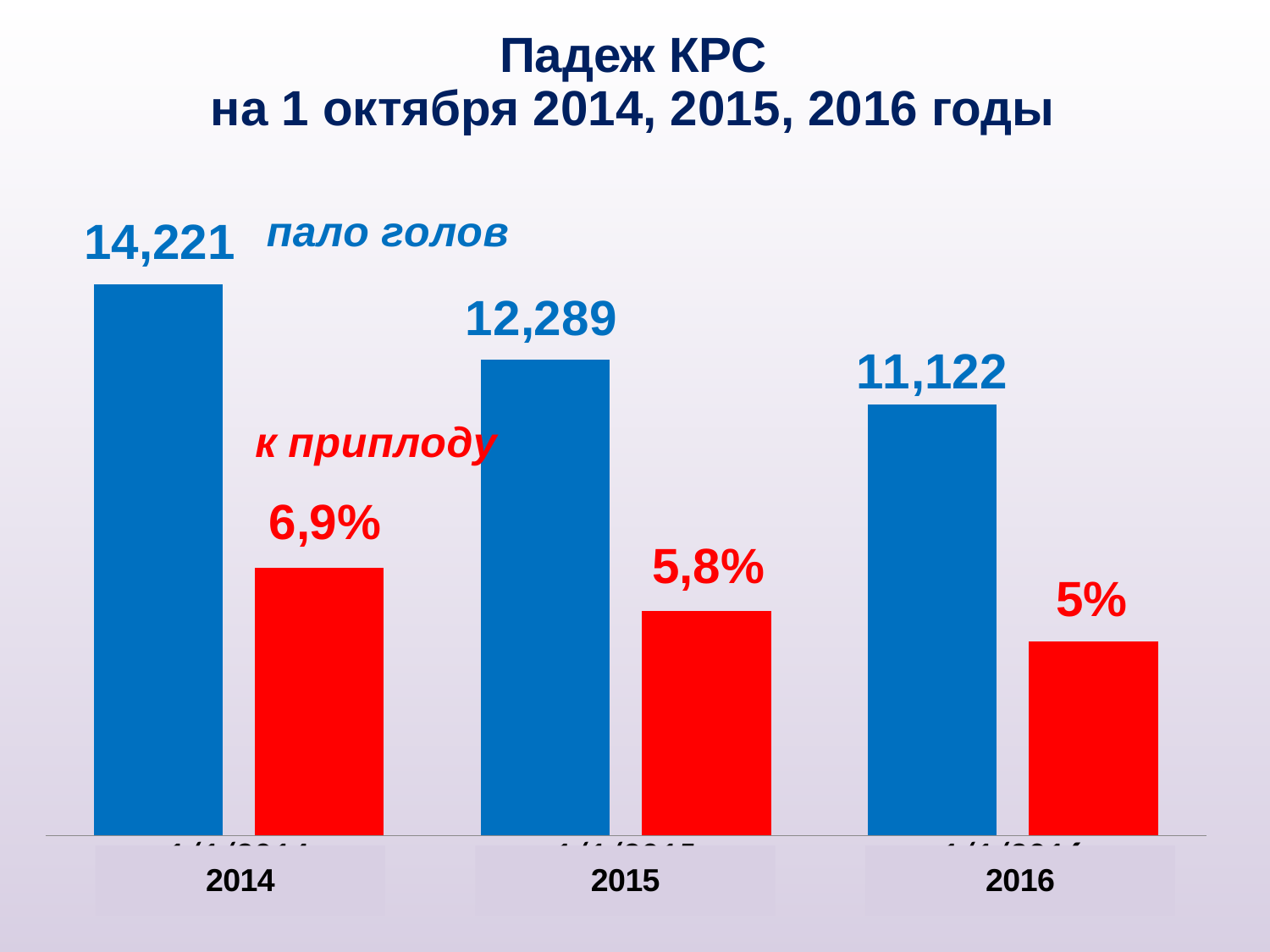
How many heads of cattle died (пало голов) as of 1 October 2015? 12,289 How many heads of cattle died (пало голов) as of 1 October 2014? 14,221 What is the percentage of deaths relative to offspring (к приплоду) for 2014? 6,9% In which year was the percentage relative to offspring (к приплоду) lowest? 2016 How many years are shown on the chart? 3 What is the difference in the number of cattle deaths between 2014 and 2016? 3,099 What is the percentage of deaths relative to offspring (к приплоду) for 2016? 5% What type of chart is shown on the slide? bar chart In which year was the number of cattle deaths (пало голов) highest? 2014 How many heads of cattle died (пало голов) as of 1 October 2016? 11,122 Do the cattle death numbers (пало голов) rise or fall from 2014 to 2016? fall Which year had more cattle deaths (пало голов), 2015 or 2016? 2015